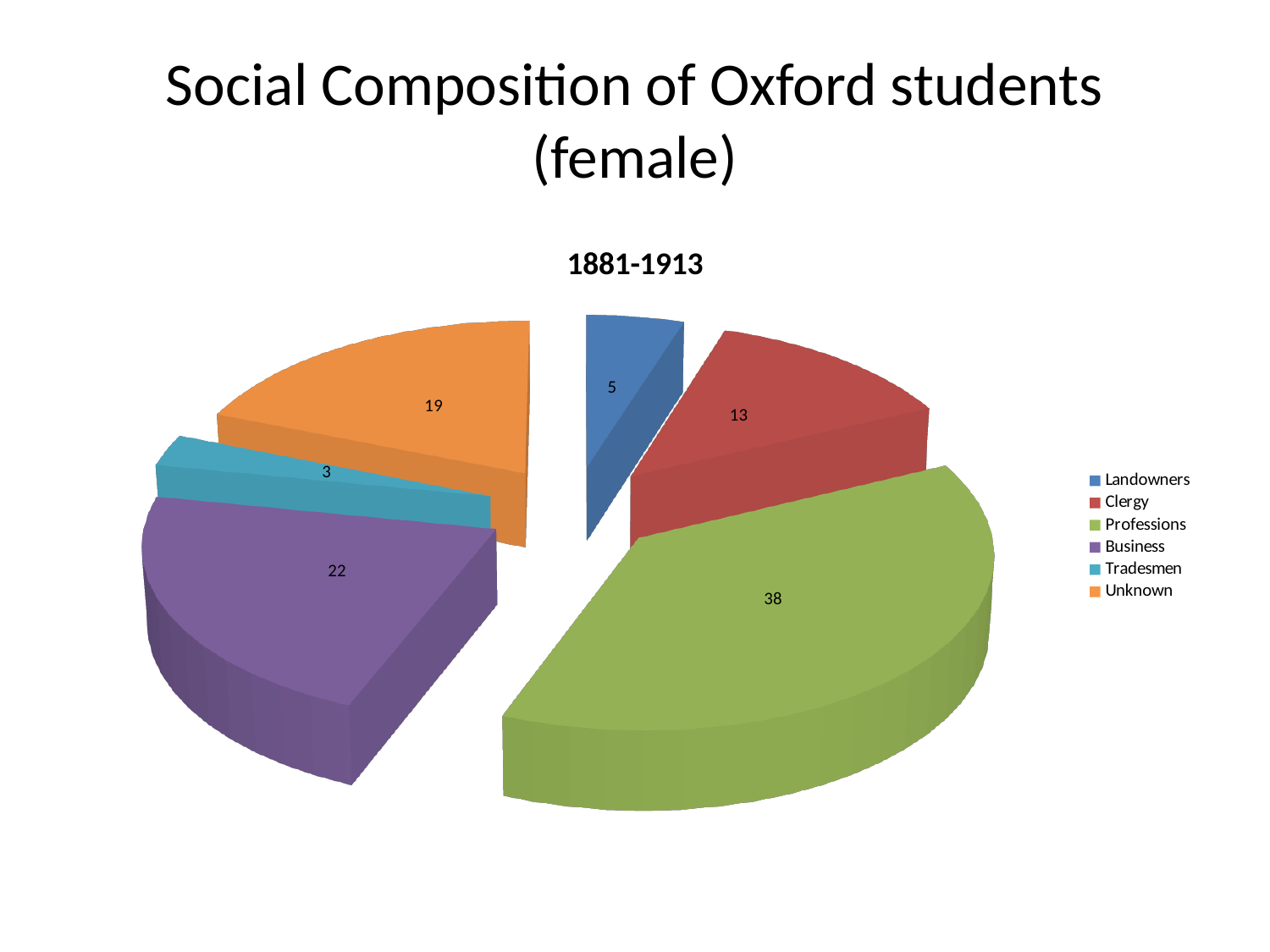
What is the difference between the values for Professions and Business? 16 What is the value for Unknown? 19 Which is larger, the value for Clergy or the value for Unknown? Unknown What is the value for Landowners? 5 How many categories does the pie chart have? 6 What kind of chart is shown on the slide? pie chart Which category has the smallest slice? Tradesmen What is the value for Professions? 38 Which category has the largest slice? Professions What is the title shown above the pie chart? 1881-1913 What is the value for Business? 22 What colour is the Business slice? purple